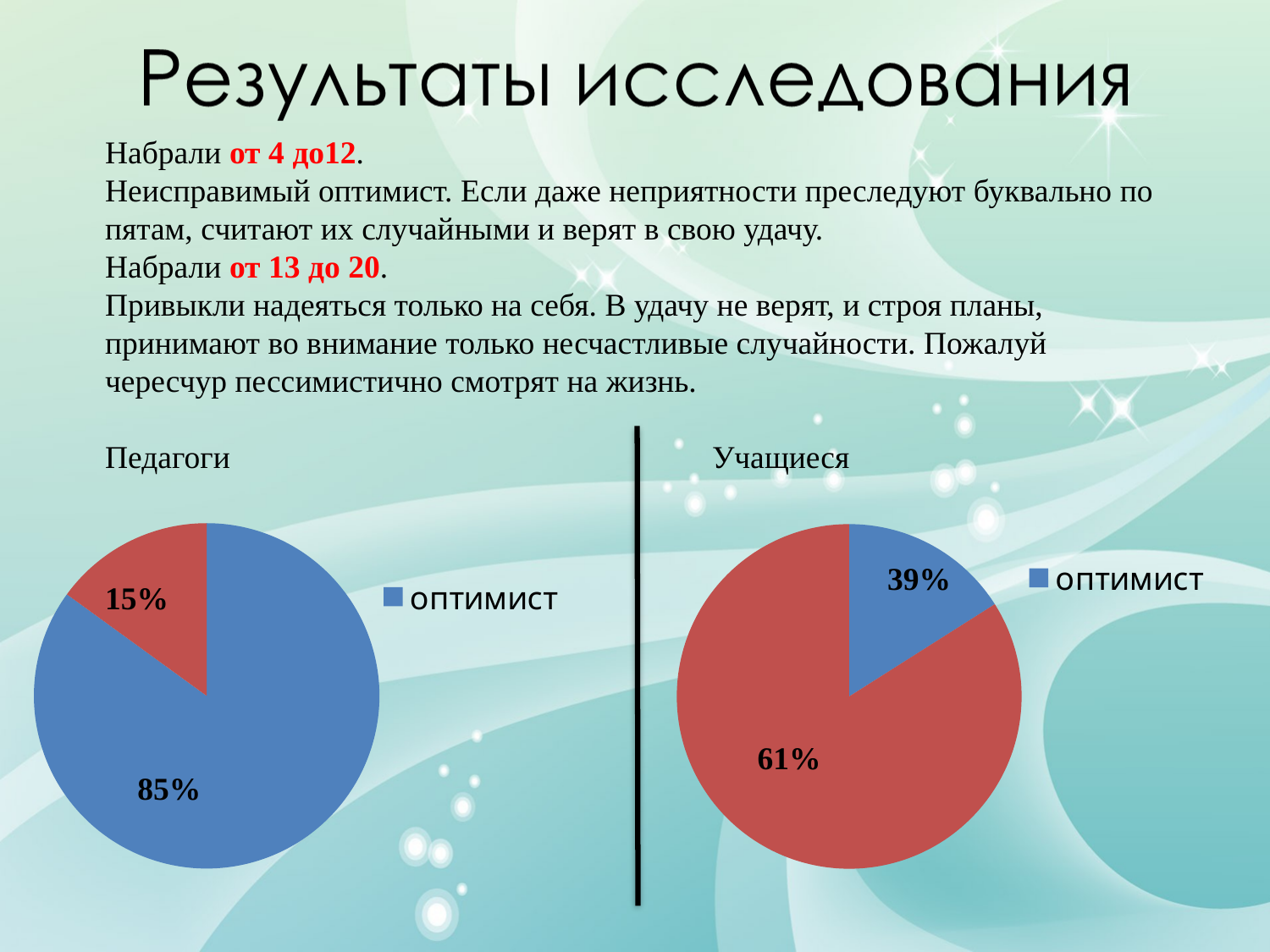
What type of chart is used on the left side of the slide under Педагоги? pie chart Which chart shows a larger share for оптимист, Педагоги or Учащиеся? Педагоги How many slices does the Учащиеся pie chart have? 2 In the Педагоги pie chart, what percentage is shown on the red slice? 15% In the Учащиеся pie chart, what percentage is shown on the red slice? 61% What is the difference between the оптимист share in the Педагоги chart and the оптимист share in the Учащиеся chart? 46% In the Педагоги pie chart, what share is labelled for the оптимист slice? 85% In the Учащиеся pie chart, what share is labelled for the оптимист slice? 39% In the Педагоги pie chart, what is the difference between the blue slice and the red slice? 70% What colour is the оптимист slice in the Учащиеся pie chart? blue How many entries does the legend of the Педагоги chart list? 1 In the Учащиеся pie chart, which slice is larger, the blue оптимист slice or the red slice? the red slice